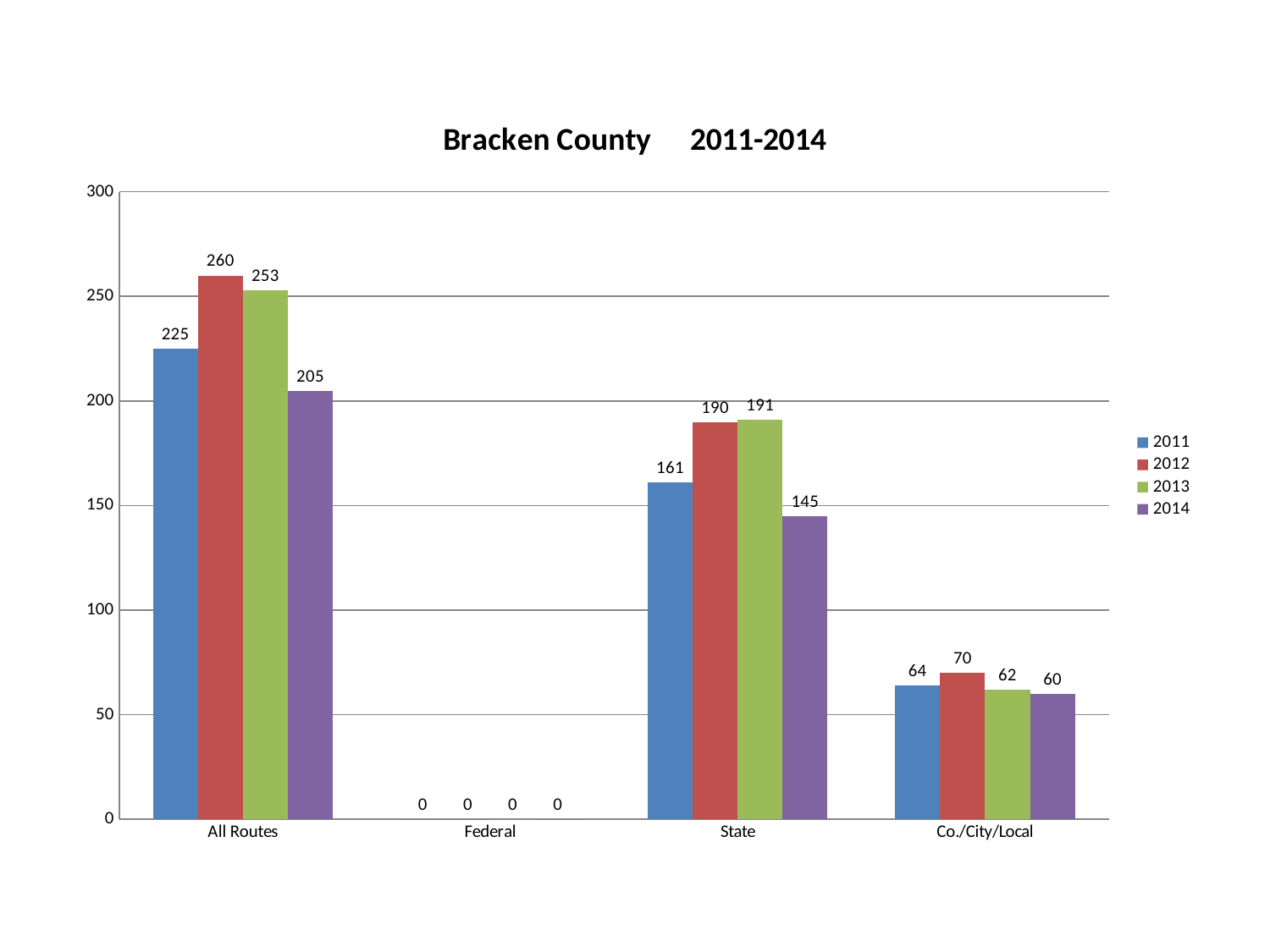
How many categories are shown on the x axis? 4 What is the value for Federal in 2013? 0 What kind of chart is shown? bar chart What is the difference between the 2012 and 2014 values for All Routes? 55 What is the title of the chart? Bracken County 2011-2014 What is the value for State in 2014? 145 What is the value for All Routes in 2012? 260 How many series does the legend list? 4 Which year has the lowest value for State? 2014 Which year has the highest value for All Routes? 2012 Which is larger, the 2011 value for State or the 2014 value for State? 2011 What is the value for Co./City/Local in 2011? 64